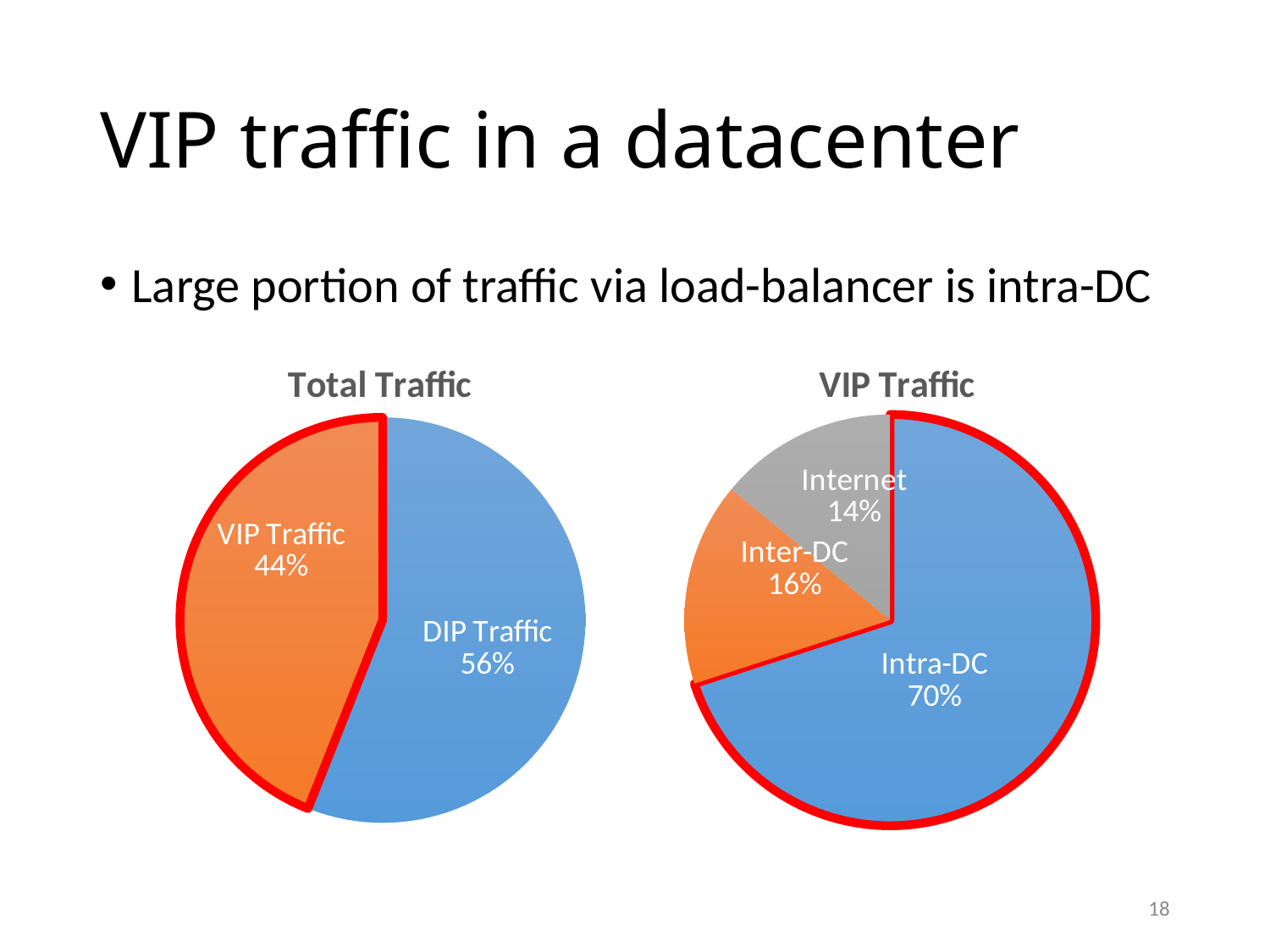
In the Total Traffic chart, what share of traffic is VIP Traffic? 44% In the Total Traffic chart, what share of traffic is DIP Traffic? 56% What kind of chart is the Total Traffic chart? Pie chart In the Total Traffic chart, which slice is larger, VIP Traffic or DIP Traffic? DIP Traffic In the VIP Traffic chart, what share of traffic is Internet? 14% In the VIP Traffic chart, which category has the largest share? Intra-DC In the VIP Traffic chart, how many slices does the pie have? 3 In the VIP Traffic chart, which category has the smallest share? Internet In the VIP Traffic chart, what is the difference in percentage points between Intra-DC and Inter-DC? 54% In the Total Traffic chart, what is the difference in percentage points between DIP Traffic and VIP Traffic? 12%